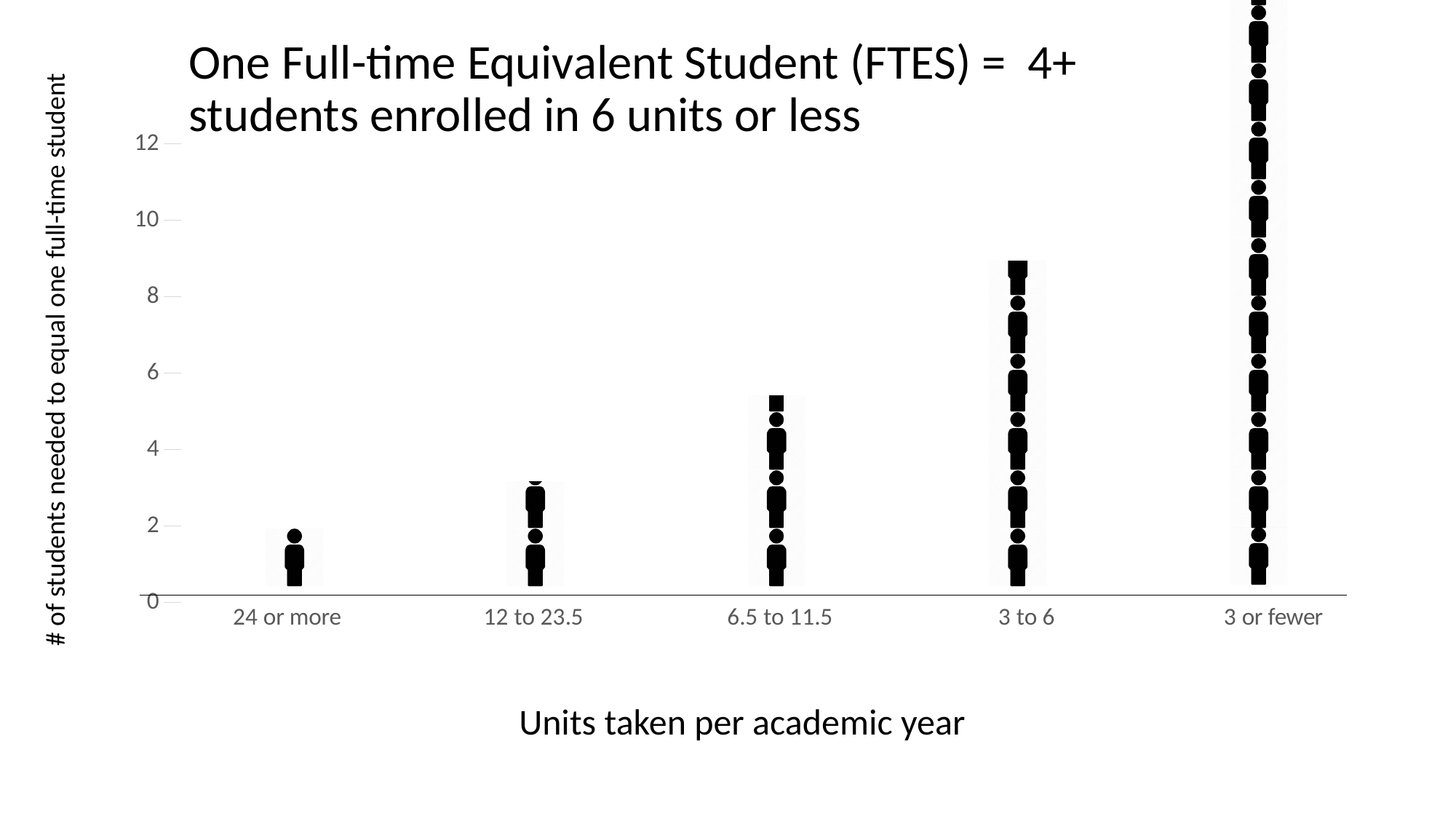
Is the value for 6.5 to 11.5 greater or less than 4? greater Is the value for 12 to 23.5 greater or less than 4? less Which is larger, the value for 3 to 6 or the value for 6.5 to 11.5? 3 to 6 Is the value for 3 or fewer greater or less than 12? greater Which category has the highest value? 3 or fewer How many categories are shown on the x axis? 5 What kind of chart is shown on the slide? bar chart Which category has the lowest value? 24 or more What is the title of the x axis? Units taken per academic year Do the values rise or fall moving from left to right along the x axis? rise